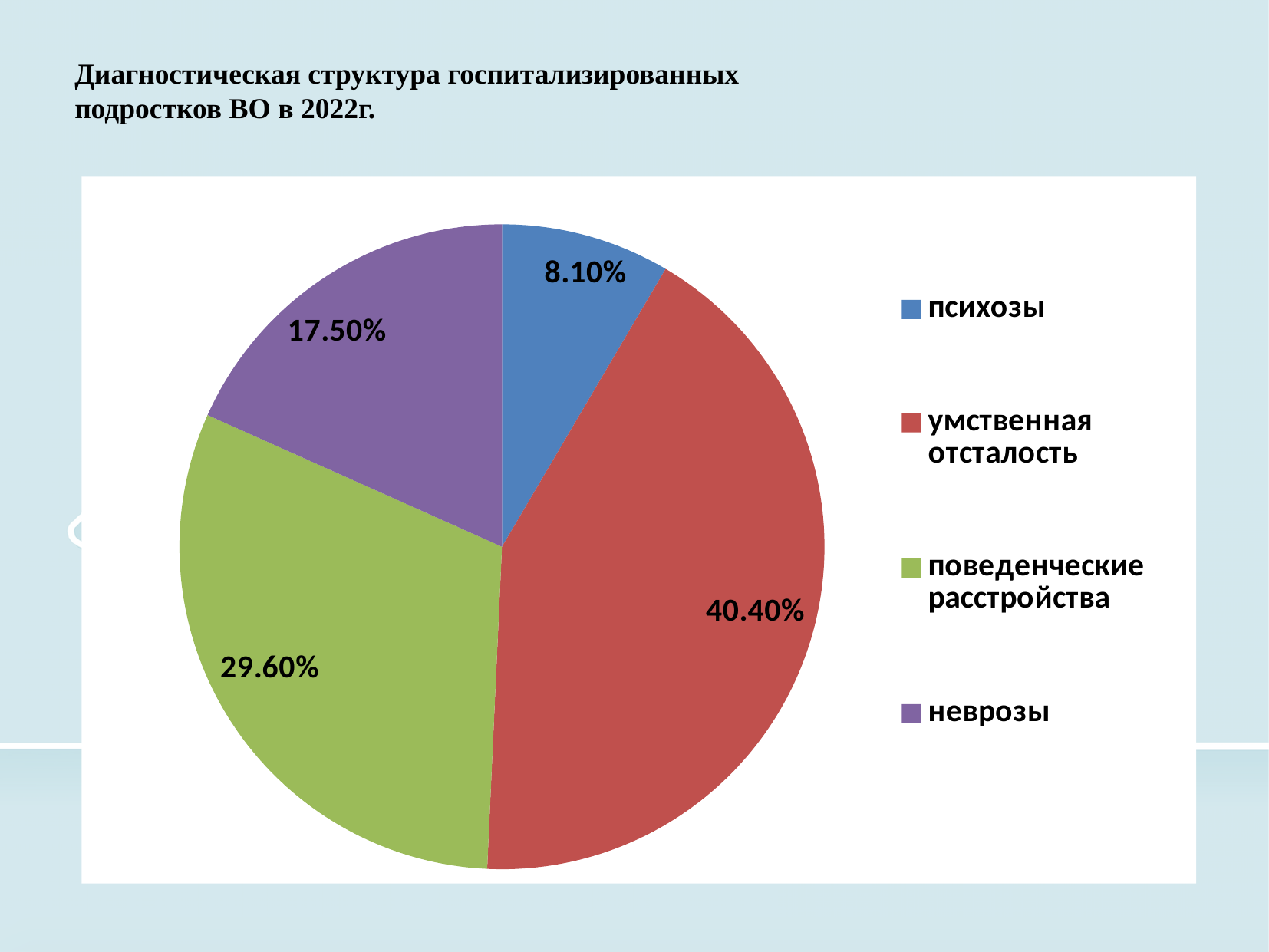
What is the difference between неврозы and психозы? 9.40% What colour is the slice for поведенческие расстройства? green Which category has the largest slice? умственная отсталость Which is larger, неврозы or психозы? неврозы What is the value for поведенческие расстройства? 29.60% What is the difference between умственная отсталость and поведенческие расстройства? 10.80% What is the value for психозы? 8.10% What is the value for неврозы? 17.50% Which category has the smallest slice? психозы How many categories does the pie chart show? 4 What type of chart is shown on the slide? pie chart What is the value for умственная отсталость? 40.40%